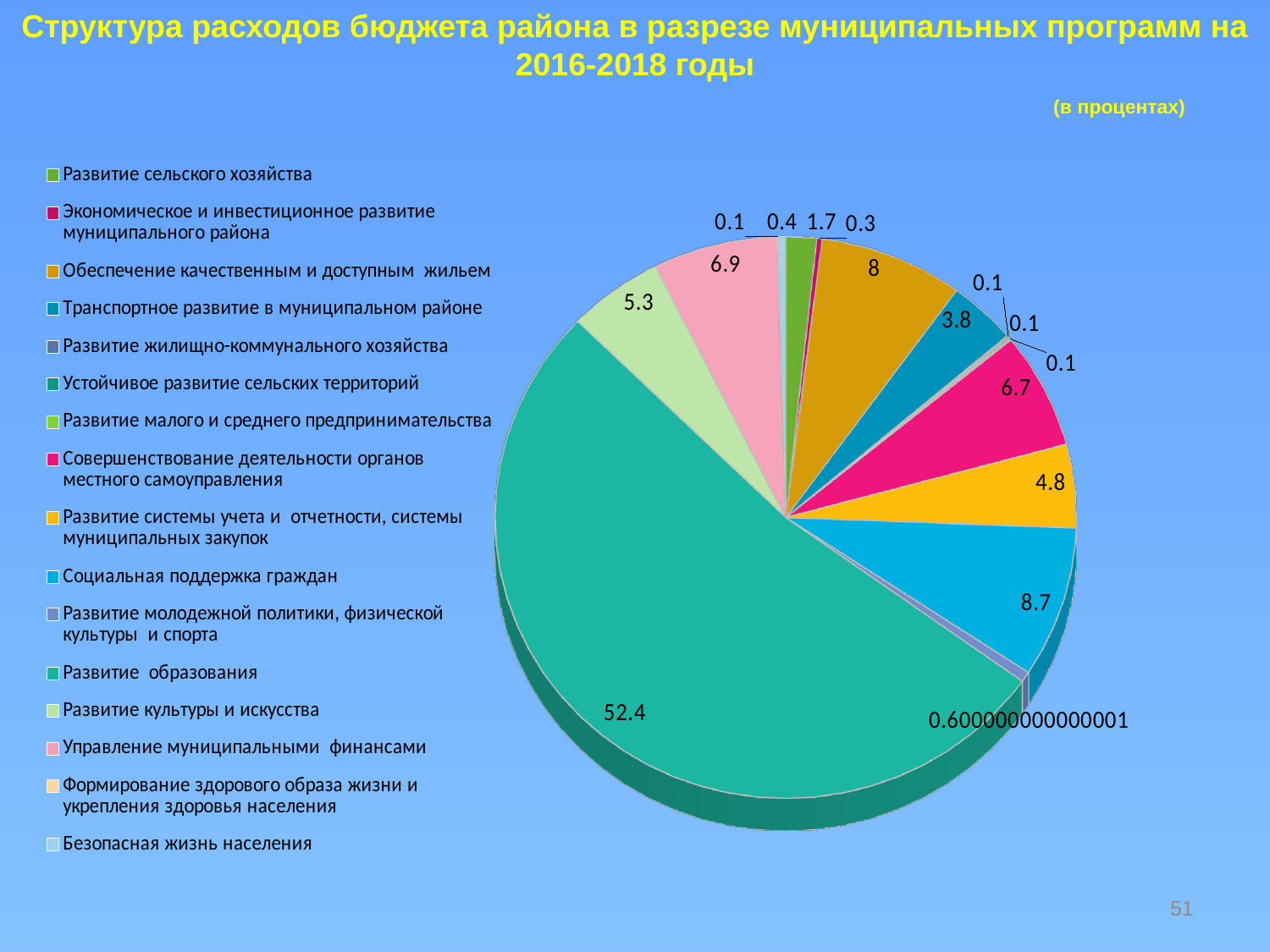
What value is shown for Социальная поддержка граждан? 8.7 What is the difference between the values for Социальная поддержка граждан and Обеспечение качественным и доступным жильем? 0.7 What kind of chart is shown on the slide? pie chart Which category has the largest slice of the pie chart? Развитие образования Which is larger: the value for Совершенствование деятельности органов местного самоуправления or the value for Развитие системы учета и отчетности, системы муниципальных закупок? Совершенствование деятельности органов местного самоуправления What is the value shown for the largest slice of the pie chart? 52.4 How many categories does the legend of the pie chart list? 16 What value is shown for Развитие культуры и искусства? 5.3 What value is shown for Обеспечение качественным и доступным жильем? 8 In what units are the values on the chart expressed, according to the note under the title? в процентах What value is shown for Управление муниципальными финансами? 6.9 Is the value for Развитие образования greater or less than 50? greater